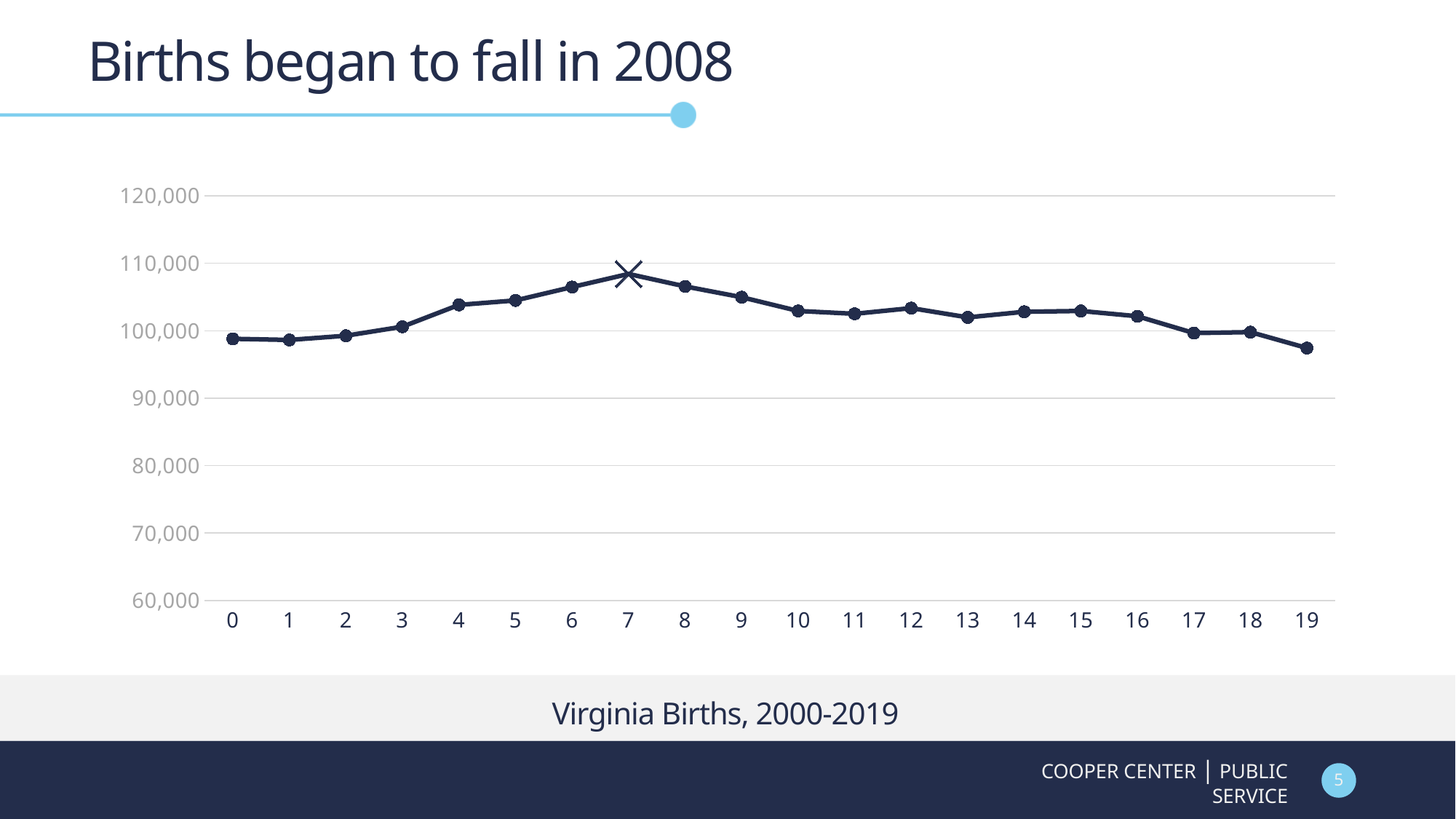
How many data points are plotted on the line? 20 Is the value at x = 7 greater or less than 110,000? less Is the value at x = 4 greater or less than 100,000? greater At which x-axis value does the line reach its highest point? 7 What kind of chart is shown on the slide? Line chart At which x-axis value does the line reach its lowest point? 19 Is the value at x = 19 greater or less than 100,000? less What is the title of the chart? Virginia Births, 2000-2019 Which is larger, the value at x = 8 or the value at x = 16? x = 8 Do the values rise or fall from x = 7 to x = 19? Fall Which is larger, the value at x = 7 or the value at x = 19? x = 7